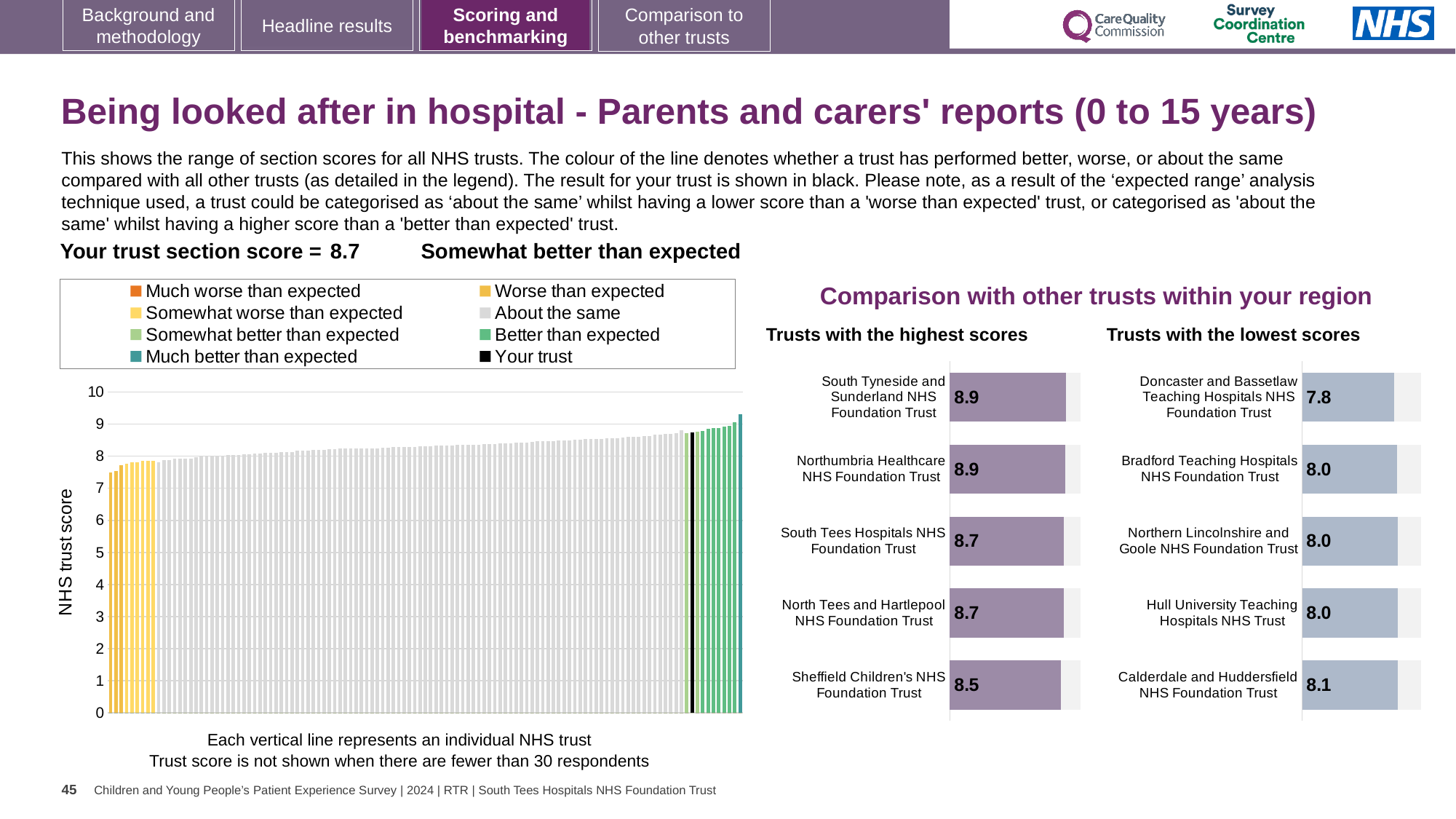
In the 'Trusts with the highest scores' chart, what is the difference between the scores of South Tyneside and Sunderland NHS Foundation Trust and Sheffield Children's NHS Foundation Trust? 0.4 In the 'Trusts with the lowest scores' chart, which has the higher score: Calderdale and Huddersfield NHS Foundation Trust or Doncaster and Bassetlaw Teaching Hospitals NHS Foundation Trust? Calderdale and Huddersfield NHS Foundation Trust In the 'Trusts with the lowest scores' chart, what is the difference between the scores of Calderdale and Huddersfield NHS Foundation Trust and Doncaster and Bassetlaw Teaching Hospitals NHS Foundation Trust? 0.3 How many trusts are shown in the 'Trusts with the highest scores' chart? 5 In the 'Trusts with the lowest scores' chart, which trust has the lowest score? Doncaster and Bassetlaw Teaching Hospitals NHS Foundation Trust In the large chart on the left, do the trust scores rise or fall from left to right? Rise In the 'Trusts with the lowest scores' chart, which trust has the highest score? Calderdale and Huddersfield NHS Foundation Trust In the 'Trusts with the highest scores' chart, what is the score for Sheffield Children's NHS Foundation Trust? 8.5 In the 'Trusts with the highest scores' chart, what is the score for South Tyneside and Sunderland NHS Foundation Trust? 8.9 What kind of chart is the large chart on the left showing NHS trust scores? Bar chart In the 'Trusts with the lowest scores' chart, what is the score for Doncaster and Bassetlaw Teaching Hospitals NHS Foundation Trust? 7.8 How many entries does the legend of the large chart on the left list? 8